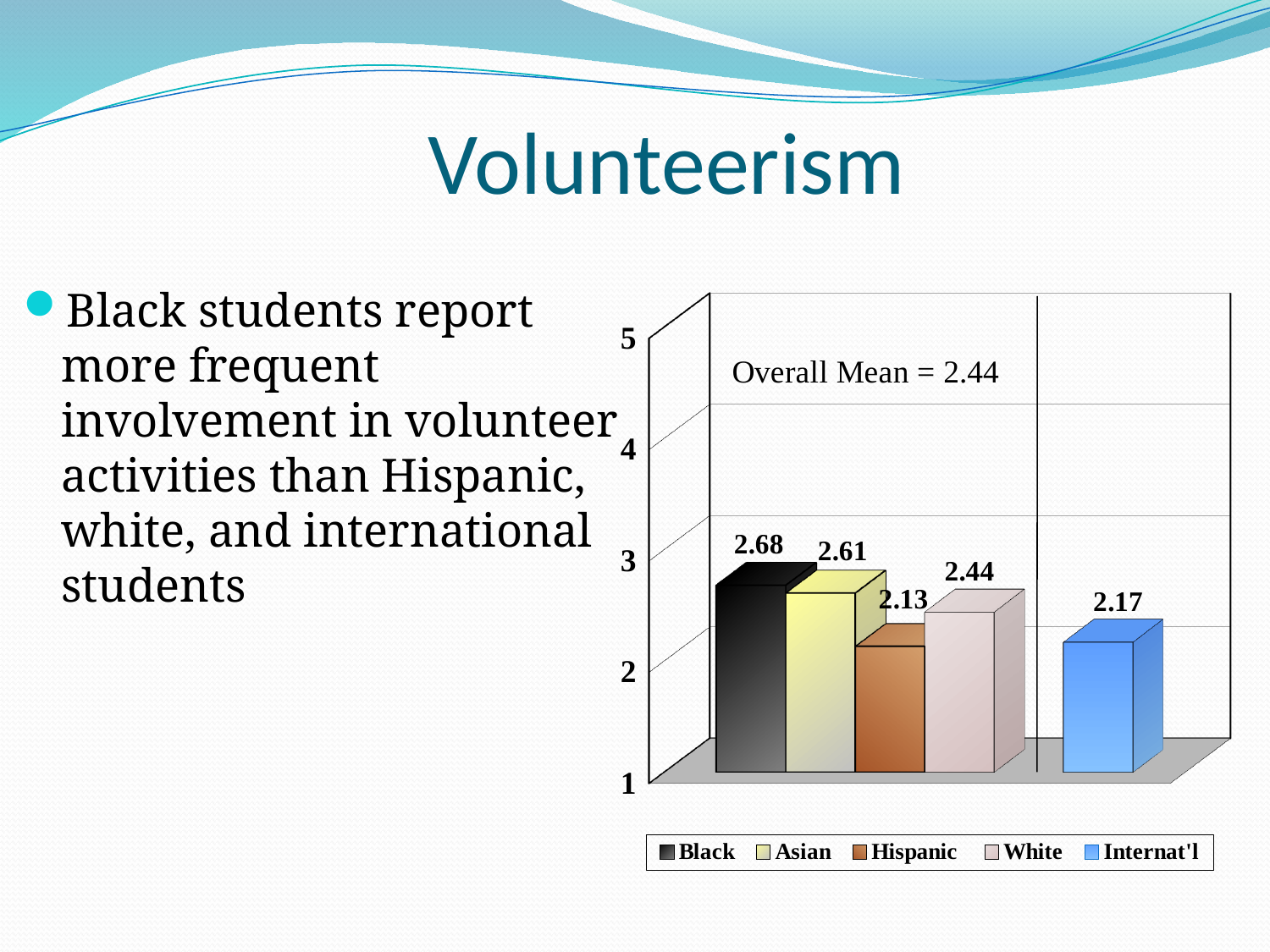
How many groups are shown in the chart legend? 5 What is the value for Black students on the chart? 2.68 Which group has the highest value on the chart? Black Which group has the lowest value on the chart? Hispanic Is the value for Asian students greater or less than 3? less What is the value for Hispanic students on the chart? 2.13 Which is larger, the value for White students or the value for Internat'l students? White What overall mean is stated on the chart? 2.44 What is the difference between the values for Black and White students? 0.24 What is the value for Internat'l students on the chart? 2.17 What kind of chart is shown on the slide? Bar chart What is the difference between the values for Asian and Hispanic students? 0.48